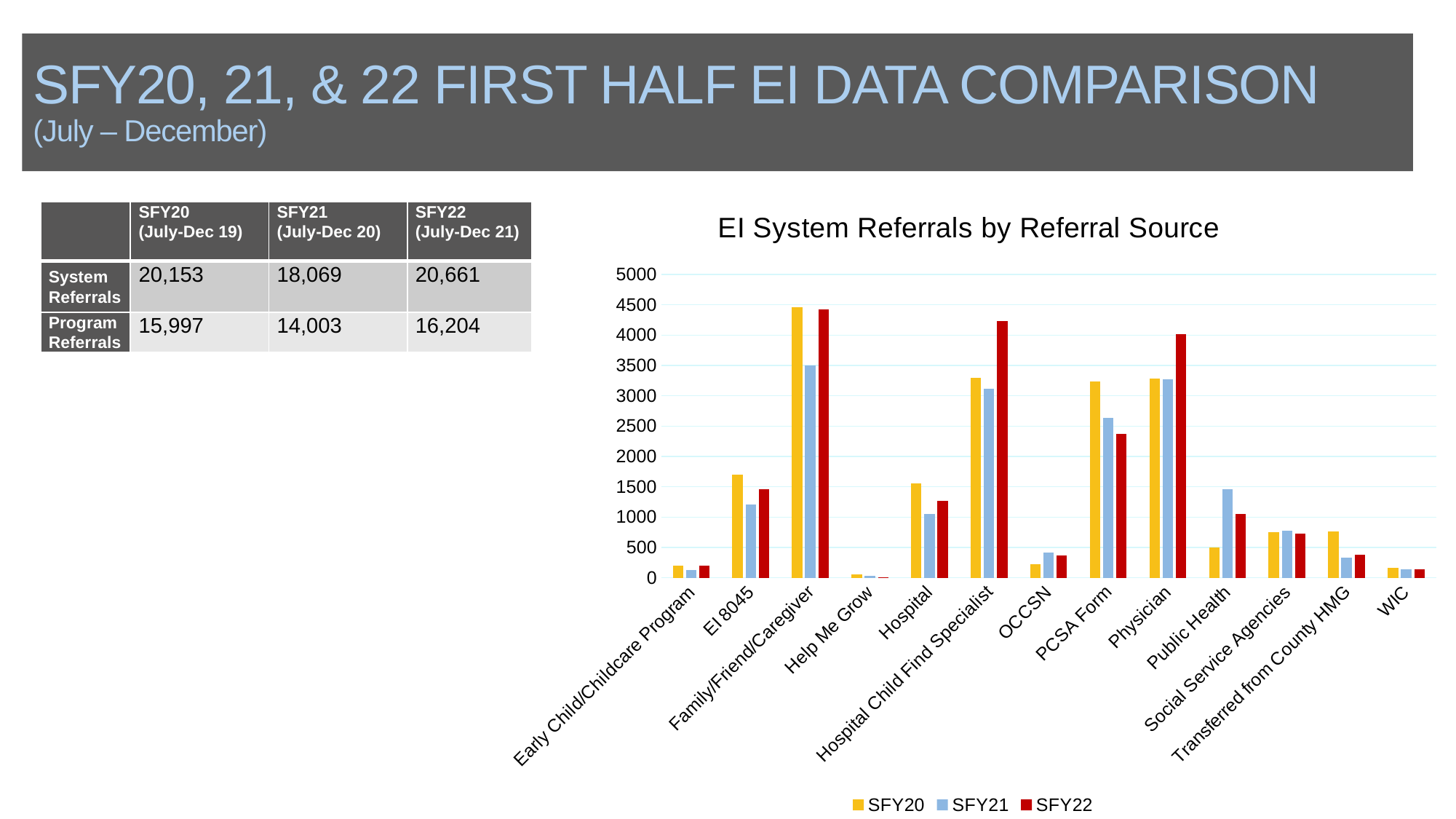
For PCSA Form, which is larger: the SFY20 value or the SFY22 value? SFY20 How many series does the chart legend list? 3 Is the SFY21 value for Public Health greater or less than 1000? greater Is the SFY22 value for PCSA Form greater or less than 2500? less What kind of chart is shown on the slide? Bar chart Is the SFY22 value for Hospital Child Find Specialist greater or less than 4000? greater Which referral source has the lowest values across all three series in the chart? Help Me Grow How many referral source categories are shown on the x axis of the chart? 13 Do the PCSA Form values rise or fall from SFY20 to SFY22? Fall For Public Health, which is larger: the SFY20 value or the SFY21 value? SFY21 What is the title of the chart? EI System Referrals by Referral Source Which referral source has the highest SFY20 value in the chart? Family/Friend/Caregiver